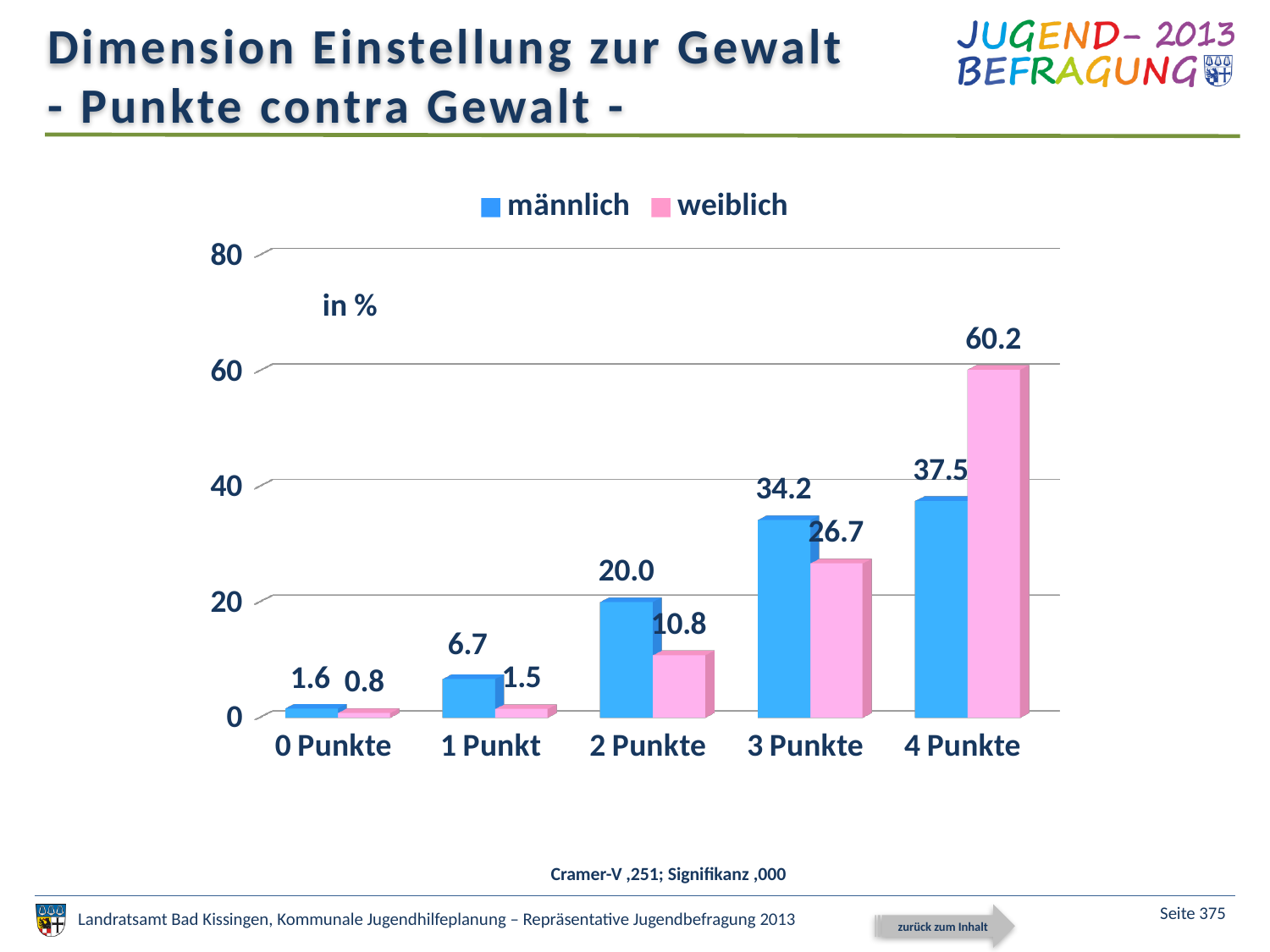
Do the values for männlich rise or fall from 0 Punkte to 4 Punkte? rise What is the value for weiblich at 0 Punkte? 0.8 Which category has the highest value for weiblich? 4 Punkte What is the value for weiblich at 2 Punkte? 10.8 How many series does the legend list? 2 Which category has the lowest value for männlich? 0 Punkte How many categories are shown on the x axis? 5 What is the value for männlich at 4 Punkte? 37.5 Is the value for weiblich at 4 Punkte greater or less than 60? greater What kind of chart is shown on the slide? bar chart What is the difference between weiblich and männlich at 4 Punkte? 22.7 Which is larger at 3 Punkte, männlich or weiblich? männlich